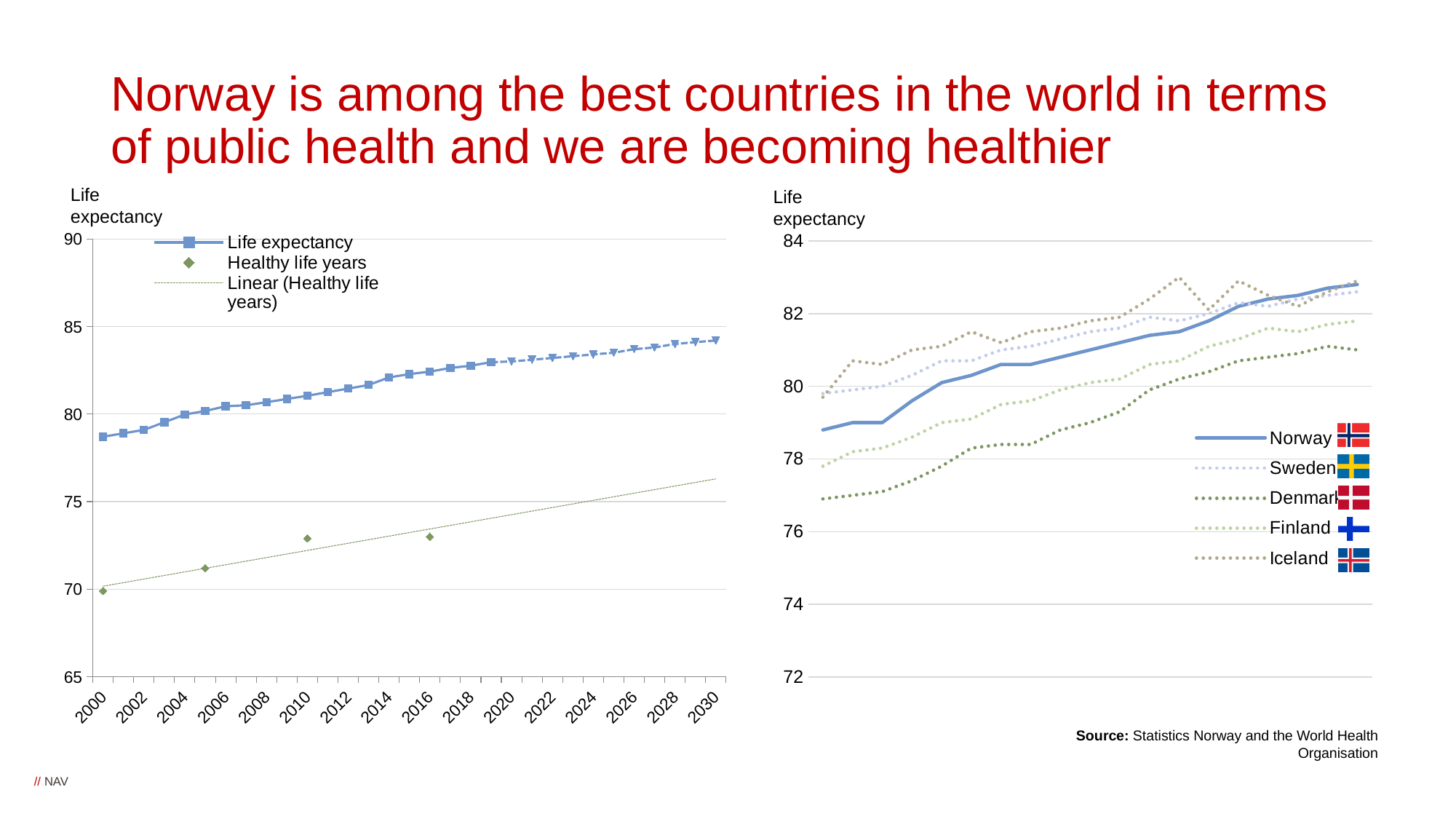
How many countries does the legend of the right chart list? 5 In the left chart, how many Healthy life years data points are plotted? 4 In the left chart, is the Healthy life years value for 2000 greater or less than 75? less How many series does the legend of the left chart list? 3 In the left chart, is the Life expectancy value for 2030 greater or less than 80? greater What kind of chart is the left chart on the slide? line chart In the left chart, is the Life expectancy value for 2000 greater or less than 80? less In the right chart, which country has the lowest life expectancy at the start of the period? Denmark What kind of chart is the right chart on the slide? line chart In the left chart, does the Life expectancy series rise or fall from 2000 to 2030? rise